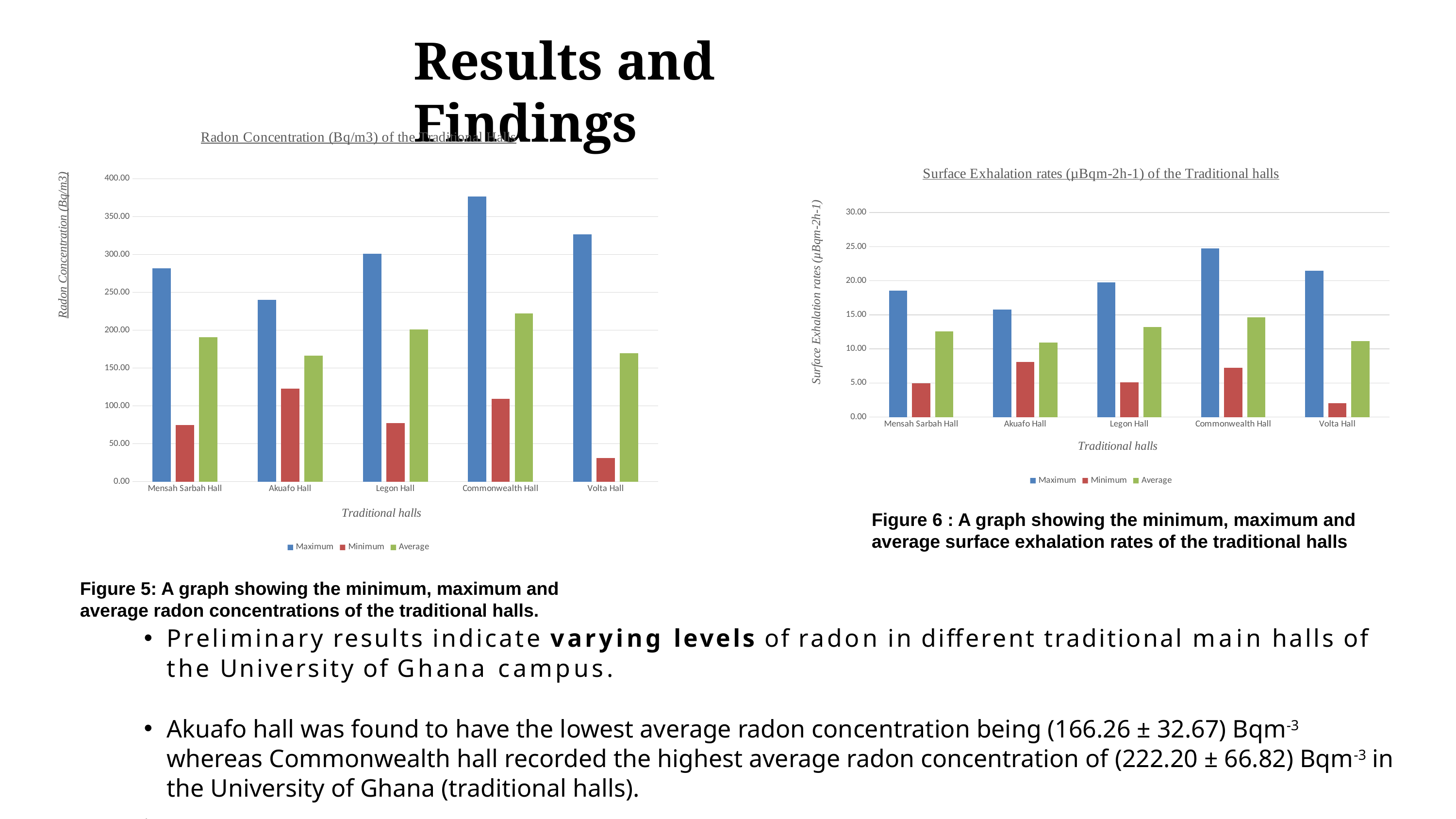
In the left chart, 'Radon Concentration (Bq/m3) of the Traditional Halls', which hall has the lowest Minimum radon concentration? Volta Hall What colour are the Minimum bars in the right chart, 'Surface Exhalation rates (µBqm-2h-1) of the Traditional halls'? red In the right chart, 'Surface Exhalation rates (µBqm-2h-1) of the Traditional halls', which hall has the lowest Minimum surface exhalation rate? Volta Hall In the right chart, 'Surface Exhalation rates (µBqm-2h-1) of the Traditional halls', is the Maximum value for Akuafo Hall greater or less than 20.00? less In the left chart, 'Radon Concentration (Bq/m3) of the Traditional Halls', which hall has the highest Maximum radon concentration? Commonwealth Hall In the right chart, 'Surface Exhalation rates (µBqm-2h-1) of the Traditional halls', which hall has the highest Maximum surface exhalation rate? Commonwealth Hall In the left chart, 'Radon Concentration (Bq/m3) of the Traditional Halls', which is larger: the Average for Commonwealth Hall or the Average for Akuafo Hall? Commonwealth Hall How many traditional halls are shown on the x axis of the left chart, 'Radon Concentration (Bq/m3) of the Traditional Halls'? 5 In the left chart, 'Radon Concentration (Bq/m3) of the Traditional Halls', is the Maximum value for Commonwealth Hall greater or less than 350.00? greater What kind of chart is the 'Radon Concentration (Bq/m3) of the Traditional Halls' chart on the left? bar chart How many series does the legend list in the right chart, 'Surface Exhalation rates (µBqm-2h-1) of the Traditional halls'? 3 In the left chart, 'Radon Concentration (Bq/m3) of the Traditional Halls', is the Minimum value for Volta Hall greater or less than 50.00? less